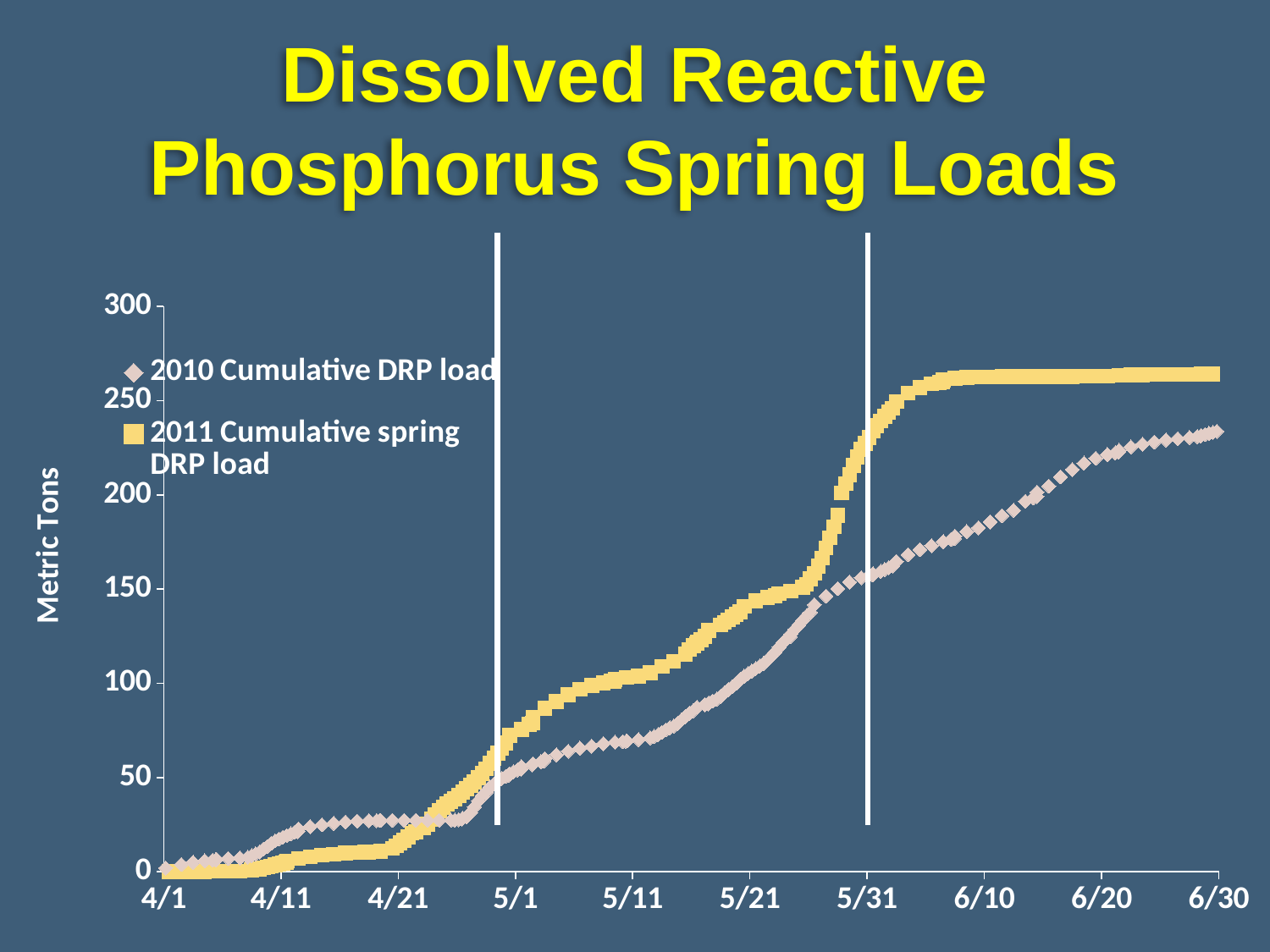
Is the value for the 2010 Cumulative DRP load at 6/30 greater or less than 200? greater How many series does the legend list? 2 At 6/30, which series has the higher value: 2010 Cumulative DRP load or 2011 Cumulative spring DRP load? 2011 Cumulative spring DRP load Do the values for the 2011 Cumulative spring DRP load series rise or fall from 4/1 to 6/30? rise At 4/11, which series has the higher value: 2010 Cumulative DRP load or 2011 Cumulative spring DRP load? 2010 Cumulative DRP load What is the label on the vertical axis? Metric Tons Is the value for the 2011 Cumulative spring DRP load at 6/30 greater or less than 250? greater Is the value for the 2010 Cumulative DRP load at 4/11 greater or less than 50? less What is the title of the chart? Dissolved Reactive Phosphorus Spring Loads What kind of chart is shown on the slide? scatter chart